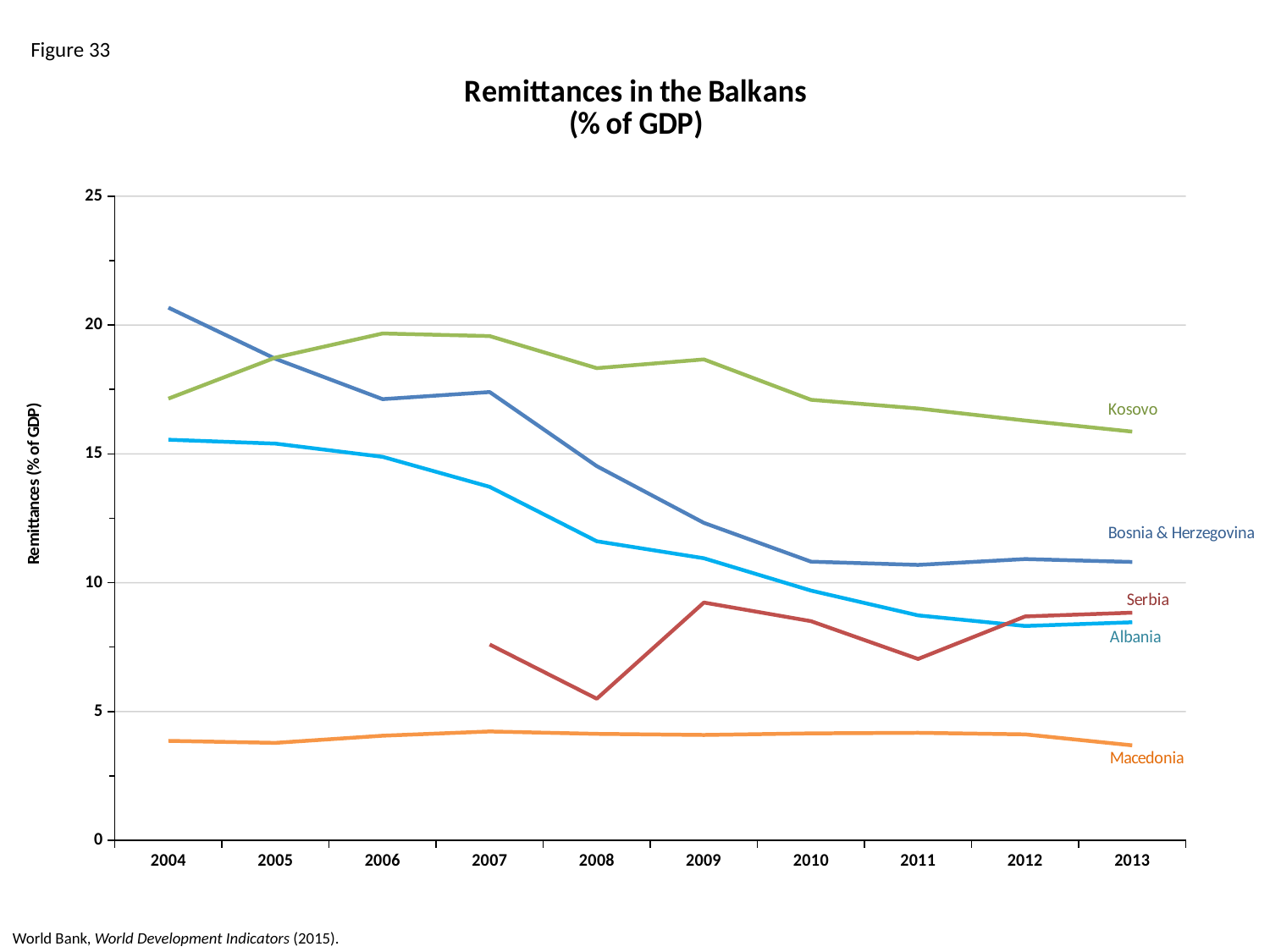
Does the line for Albania rise or fall from 2004 to 2013? fall Which country has the highest remittances as a share of GDP in 2013? Kosovo How many years are shown on the x axis? 10 Is the value for Albania in 2013 greater or less than 10? less Is the value for Kosovo in 2006 greater or less than 15? greater What kind of chart is shown on the slide? line chart How many countries are plotted in the chart? 5 Is the value for Macedonia in 2013 greater or less than 5? less Which country has the lowest remittances as a share of GDP in 2013? Macedonia Which country has the highest remittances as a share of GDP in 2004? Bosnia & Herzegovina In 2004, which is higher: Kosovo or Bosnia & Herzegovina? Bosnia & Herzegovina What is the title of the chart? Remittances in the Balkans (% of GDP)